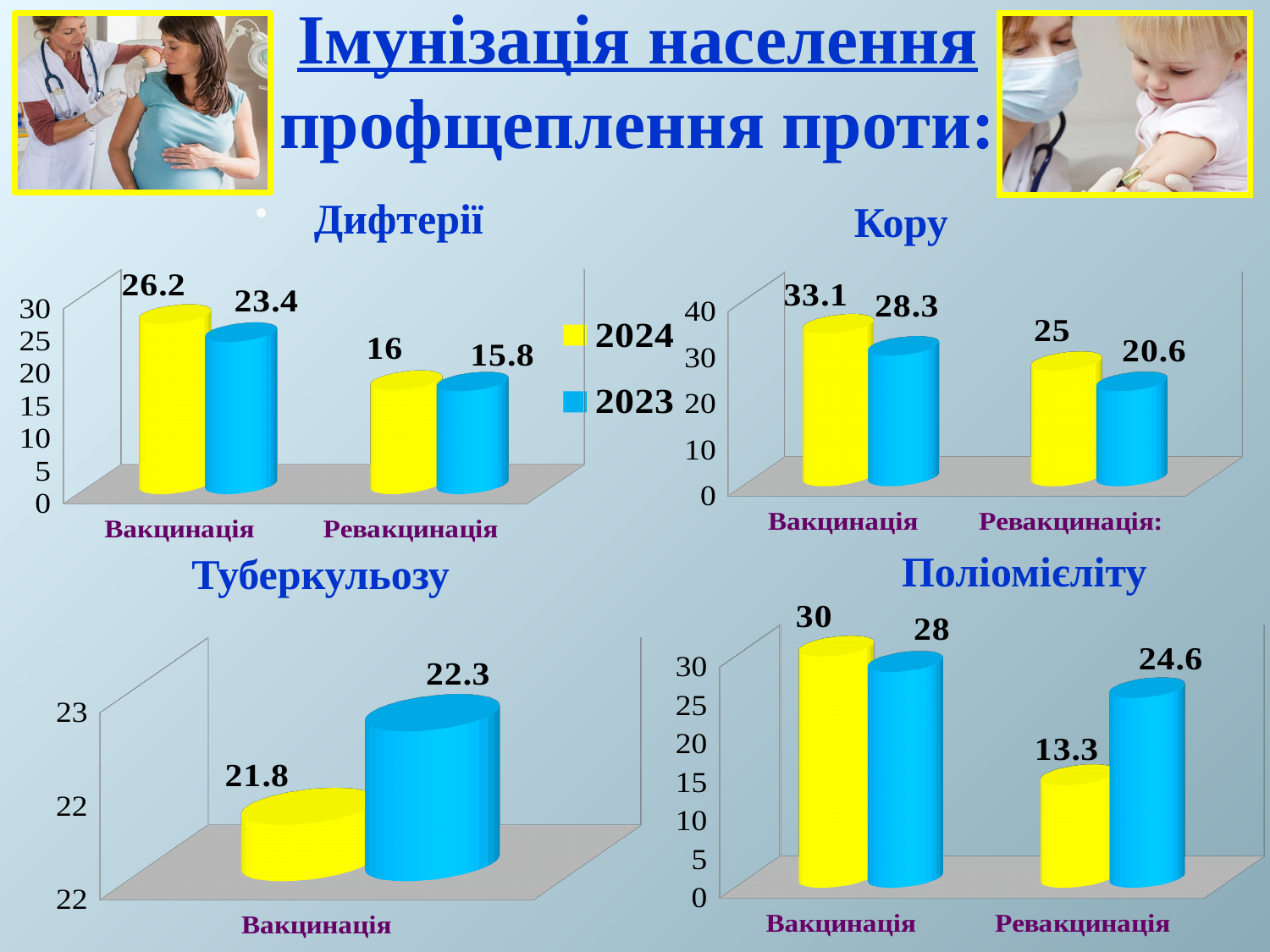
In the Дифтерії chart, what is the value for Ревакцинація in 2023? 15.8 In the Дифтерії chart, what is the difference between the 2024 and 2023 values for Вакцинація? 2.8 How many series does the legend list? 2 In the Кору chart, what is the value for Ревакцинація in 2023? 20.6 In the Туберкульозу chart, which year has the larger value for Вакцинація, 2024 or 2023? 2023 What kind of chart is the Кору chart? Bar chart In the Дифтерії chart, what is the value for Вакцинація in 2024? 26.2 In the Туберкульозу chart, what is the value for Вакцинація in 2023? 22.3 In the Поліомієліту chart, what is the value for Ревакцинація in 2024? 13.3 In the Поліомієліту chart, what is the difference between the 2023 and 2024 values for Ревакцинація? 11.3 In the Кору chart, which category has the highest value? Вакцинація (2024) In the Кору chart, what is the value for Вакцинація in 2024? 33.1